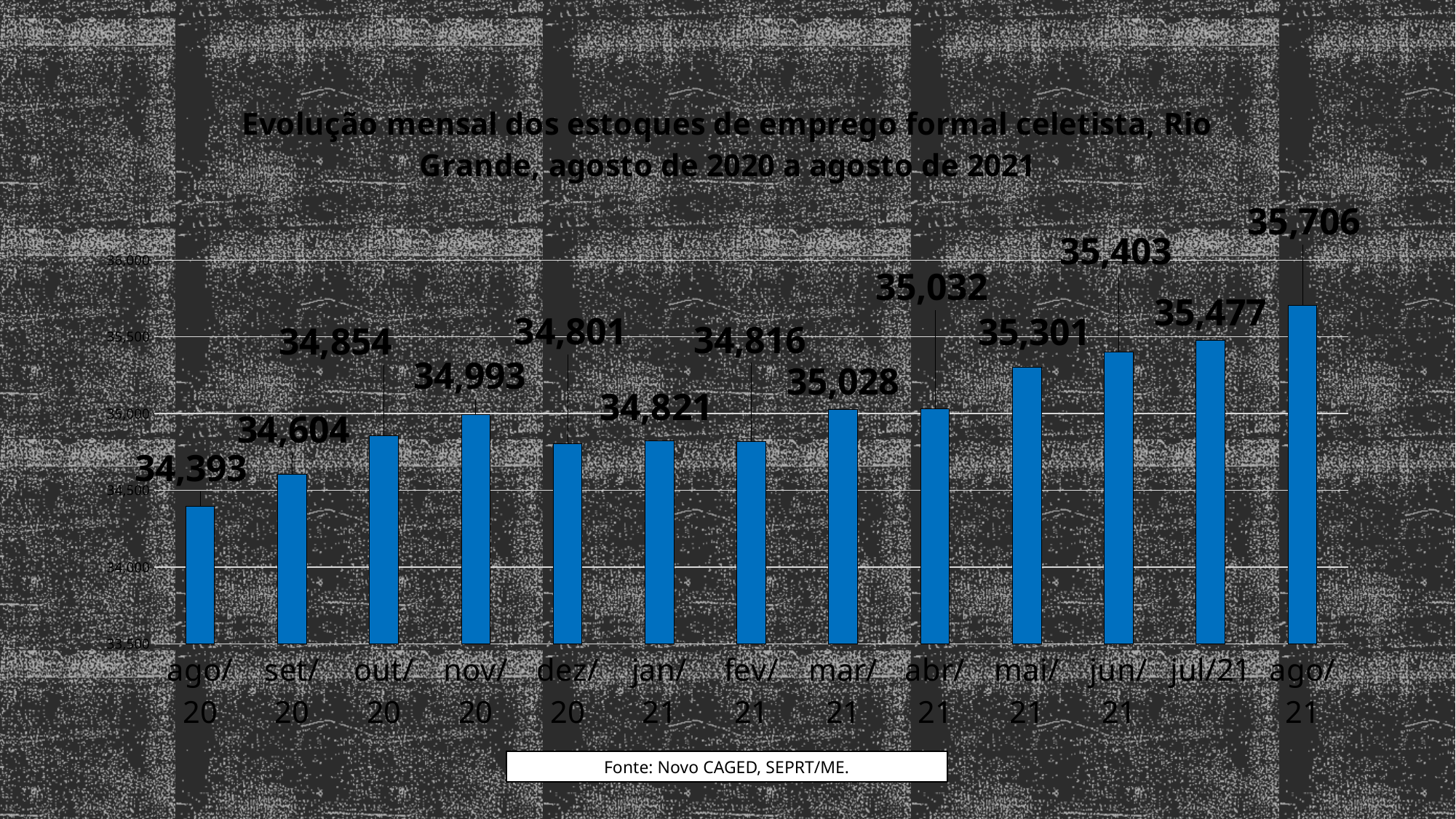
Is the value for set/20 greater or less than 35,000? less What is the value for mar/21? 35,028 What is the value for dez/20? 34,801 Which is larger, the value for nov/20 or the value for dez/20? nov/20 What is the value for ago/21? 35,706 How many months are shown on the x axis? 13 Which month has the highest value? ago/21 What kind of chart is shown on the slide? bar chart Which month has the lowest value? ago/20 What is the difference between the values for ago/21 and ago/20? 1,313 What source is cited below the chart? Novo CAGED, SEPRT/ME. What is the difference between the values for jun/21 and mai/21? 102